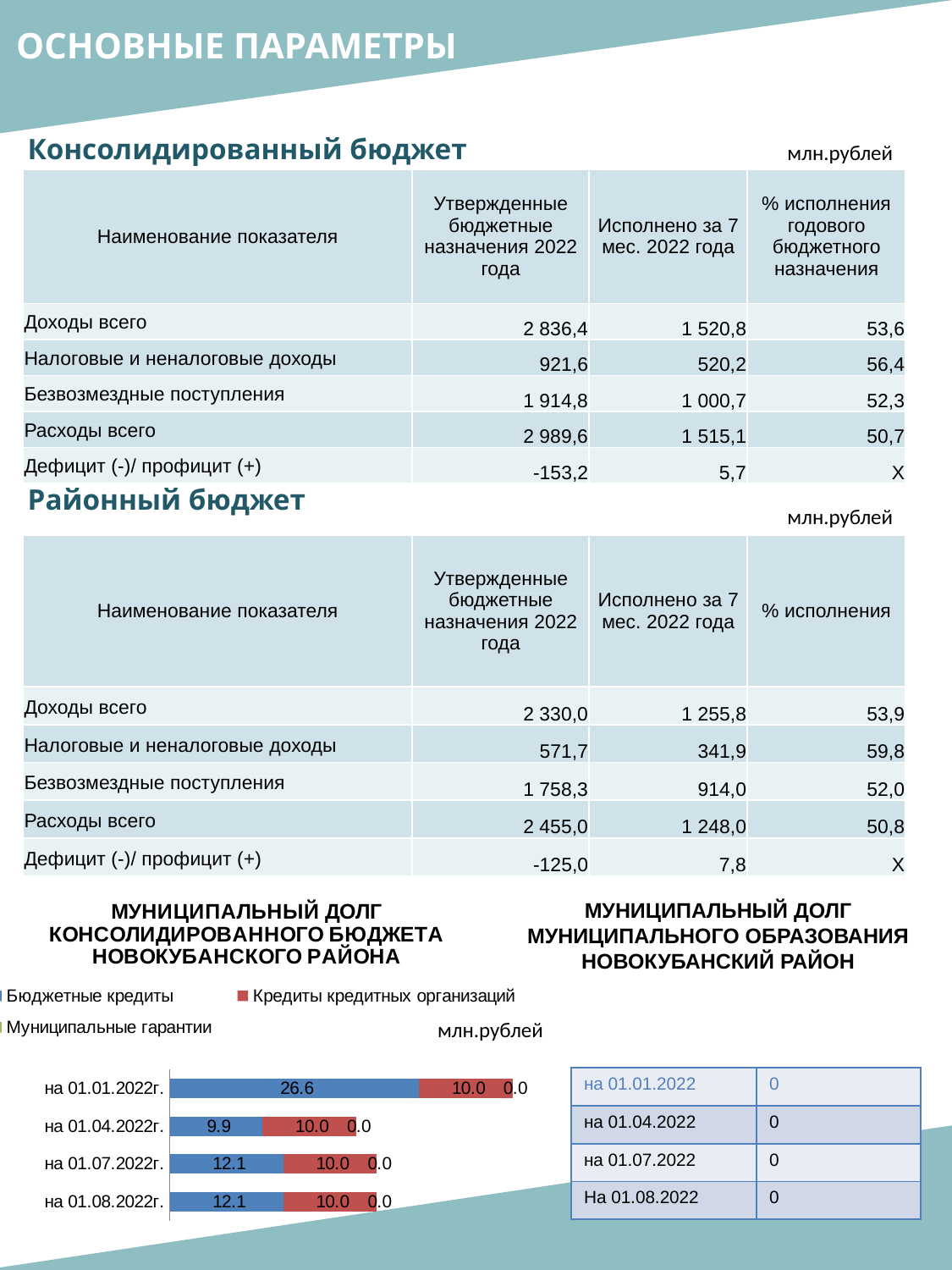
In the municipal debt chart, what is the value of 'Кредиты кредитных организаций' for 'на 01.07.2022г.'? 10.0 In the municipal debt chart, what is the total of the stacked bar for 'на 01.01.2022г.'? 36.6 How many dates (categories) are plotted in the municipal debt chart? 4 How many series does the legend of the municipal debt chart list? 3 In the municipal debt chart, which is larger for 'на 01.08.2022г.': 'Бюджетные кредиты' or 'Кредиты кредитных организаций'? Бюджетные кредиты In the municipal debt chart, what is the difference in 'Бюджетные кредиты' between 'на 01.01.2022г.' and 'на 01.04.2022г.'? 16.7 What kind of chart is shown under the title 'МУНИЦИПАЛЬНЫЙ ДОЛГ КОНСОЛИДИРОВАННОГО БЮДЖЕТА НОВОКУБАНСКОГО РАЙОНА'? Stacked bar chart In the municipal debt chart, what is the value of 'Бюджетные кредиты' for 'на 01.01.2022г.'? 26.6 In the municipal debt chart, what is the value of 'Бюджетные кредиты' for 'на 01.04.2022г.'? 9.9 In the municipal debt chart, on which date is 'Бюджетные кредиты' highest? на 01.01.2022г. In the municipal debt chart, what is the value of 'Муниципальные гарантии' for 'на 01.08.2022г.'? 0.0 In the municipal debt chart, on which date is 'Бюджетные кредиты' lowest? на 01.04.2022г.